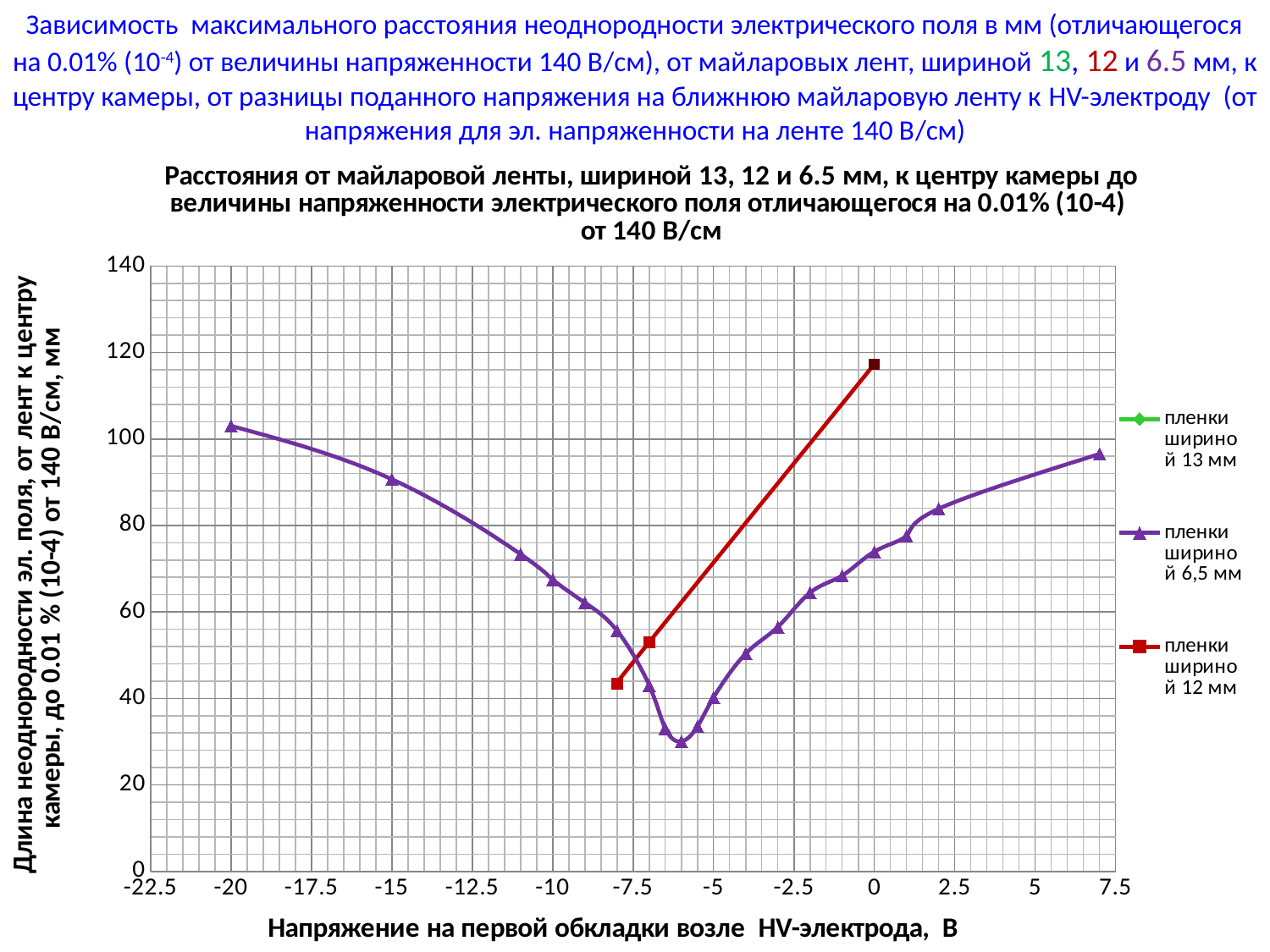
Is the value of the 'пленки шириной 6,5 мм' series at 0 V greater or less than 80? less How many series does the legend list? 3 How many data points are plotted for the series 'пленки шириной 12 мм'? 3 What is the title of the x axis? Напряжение на первой обкладки возле HV-электрода, В Is the lowest value of the 'пленки шириной 6,5 мм' series greater or less than 40? less Which series is drawn in red with square markers? пленки шириной 12 мм Does the 'пленки шириной 12 мм' series rise or fall as the voltage increases from -8 V to 0 V? rise Is the value of the 'пленки шириной 12 мм' series at 0 V greater or less than 100? greater At 0 V, which series has the larger value: 'пленки шириной 12 мм' or 'пленки шириной 6,5 мм'? пленки шириной 12 мм What kind of chart is shown on the slide? line chart